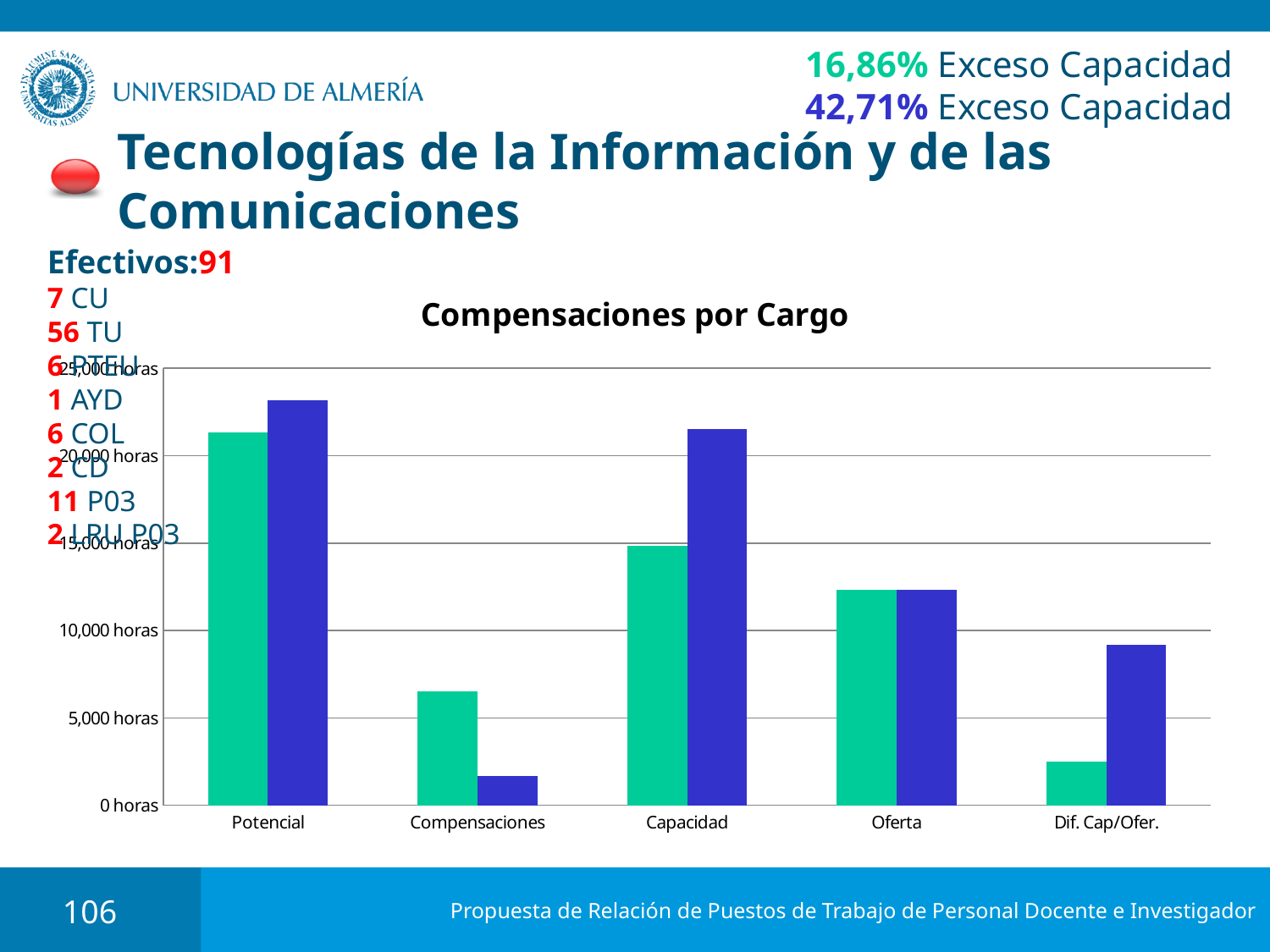
Which category has the tallest blue bar? Potencial Is the green bar for Potencial greater or less than 20,000 horas? greater Is the blue bar for Dif. Cap/Ofer. greater or less than 10,000 horas? less What is the title of the chart? Compensaciones por Cargo For Compensaciones, which bar is taller, the green one or the blue one? green Is the blue bar for Compensaciones greater or less than 5,000 horas? less For Dif. Cap/Ofer., which bar is taller, the green one or the blue one? blue Which category has the shortest green bar? Dif. Cap/Ofer. How many categories are shown on the x axis of the chart? 5 What kind of chart is shown on the slide? bar chart